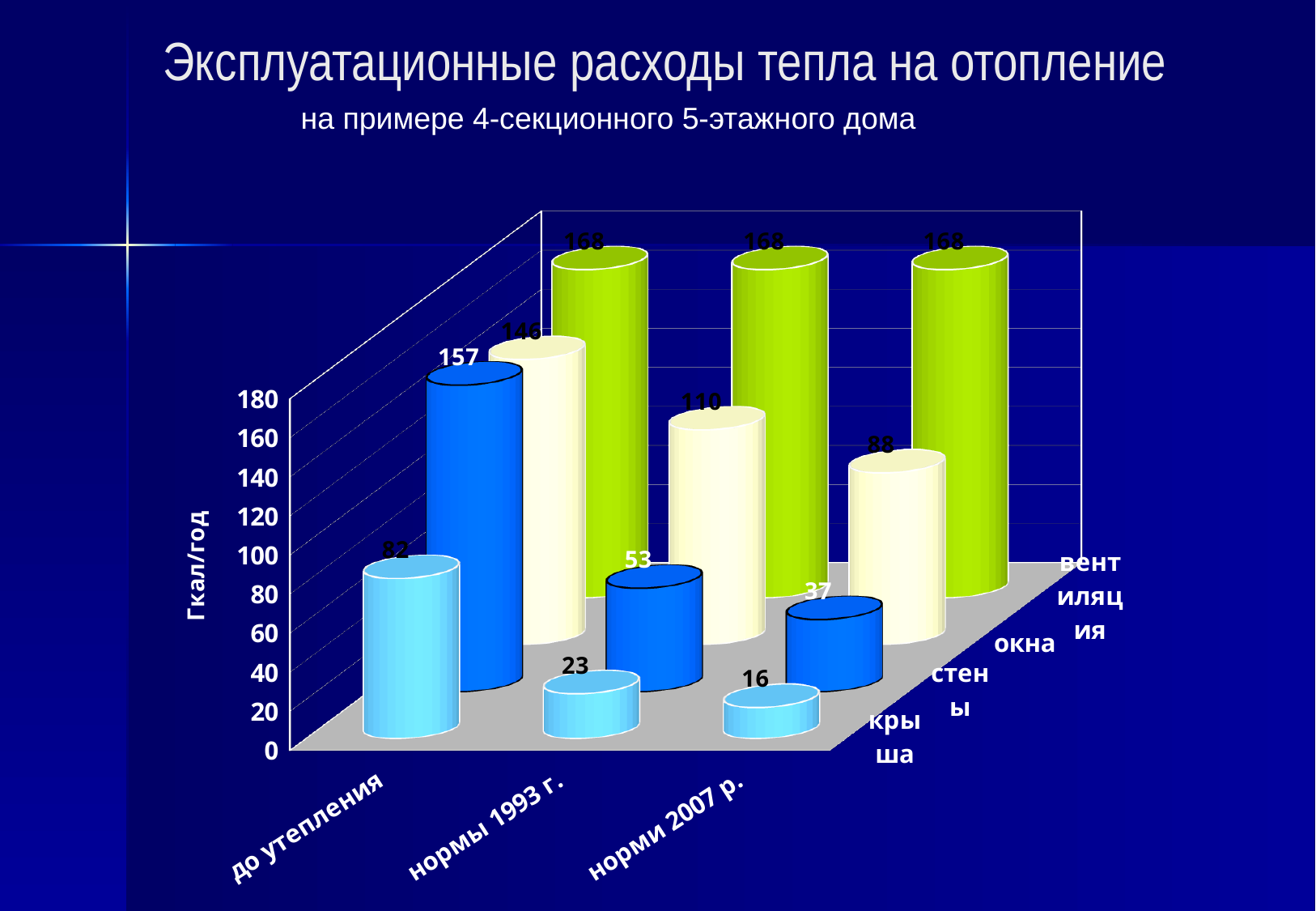
Which is larger: окна under нормы 1993 г. or стены under до утепления? стены under до утепления What is the difference between the стены values for до утепления and норми 2007 р.? 120 What is the value for крыша under до утепления? 82 What is the value for окна under норми 2007 р.? 88 What is the unit shown on the vertical axis? Гкал/год Which category has the lowest value for крыша? норми 2007 р. What is the value for стены under нормы 1993 г.? 53 Which series has the highest value under до утепления? вентиляция What kind of chart is shown on the slide? bar chart How many categories are shown along the x axis? 3 What is the value for вентиляция under нормы 1993 г.? 168 How many series are plotted in the chart? 4